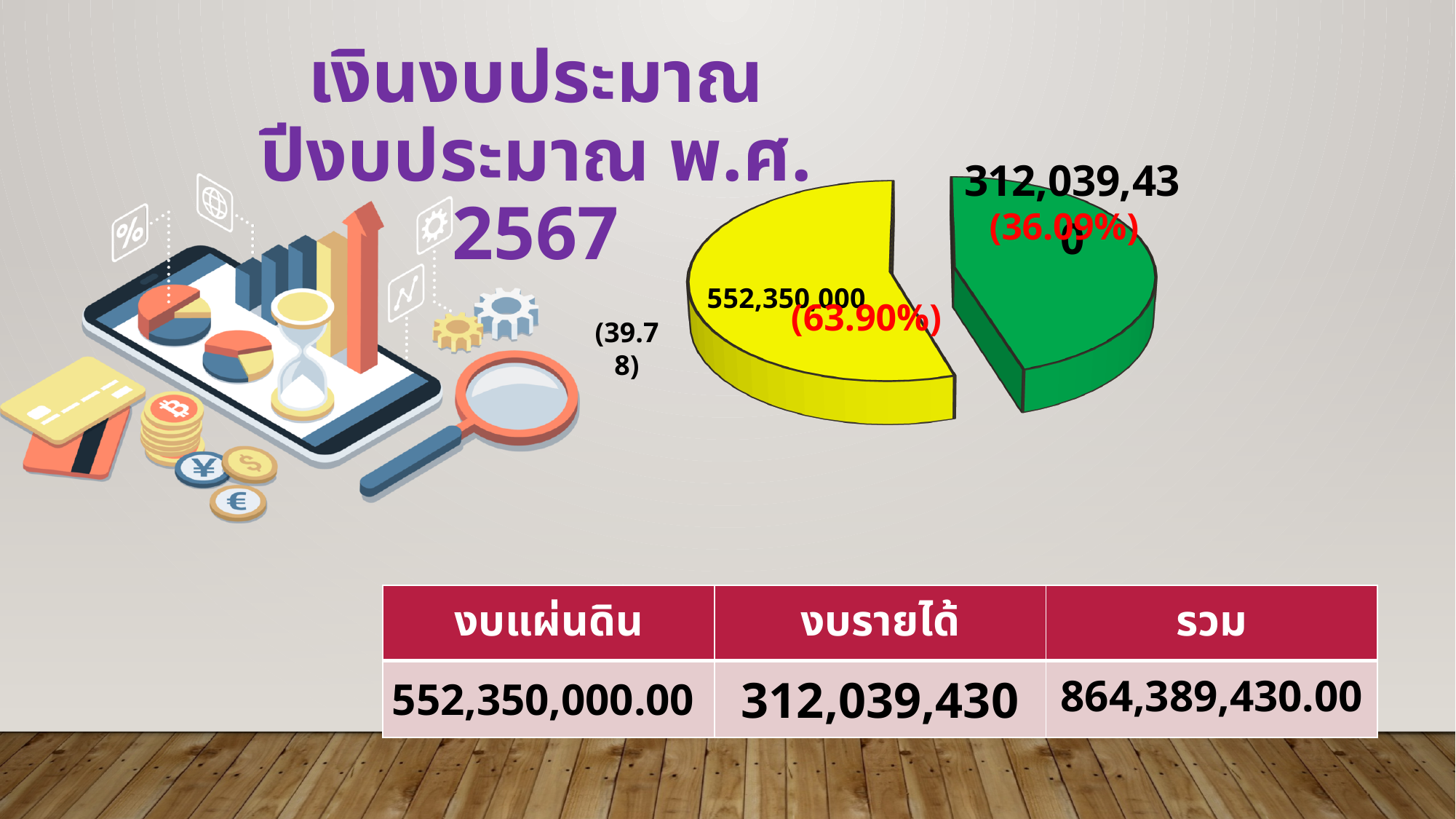
What value is labelled on the yellow slice of the pie chart? 552,350,000 What is the title text shown above the pie chart on the slide? เงินงบประมาณ ปีงบประมาณ พ.ศ. 2567 How many slices does the pie chart have? 2 Which slice of the pie chart is the smallest? the green slice (312,039,430) What is the difference between the yellow slice value (552,350,000) and the green slice value (312,039,430) in the pie chart? 240,310,570 What percentage share is shown for the green slice of the pie chart? 36.09% What two colours are used for the slices of the pie chart? yellow and green Which is larger in the pie chart, the yellow slice or the green slice? the yellow slice Which slice of the pie chart is the largest? the yellow slice (552,350,000) What kind of chart is shown on the slide? pie chart What value is labelled on the green slice of the pie chart? 312,039,430 What percentage share is shown for the yellow slice of the pie chart? 63.90%